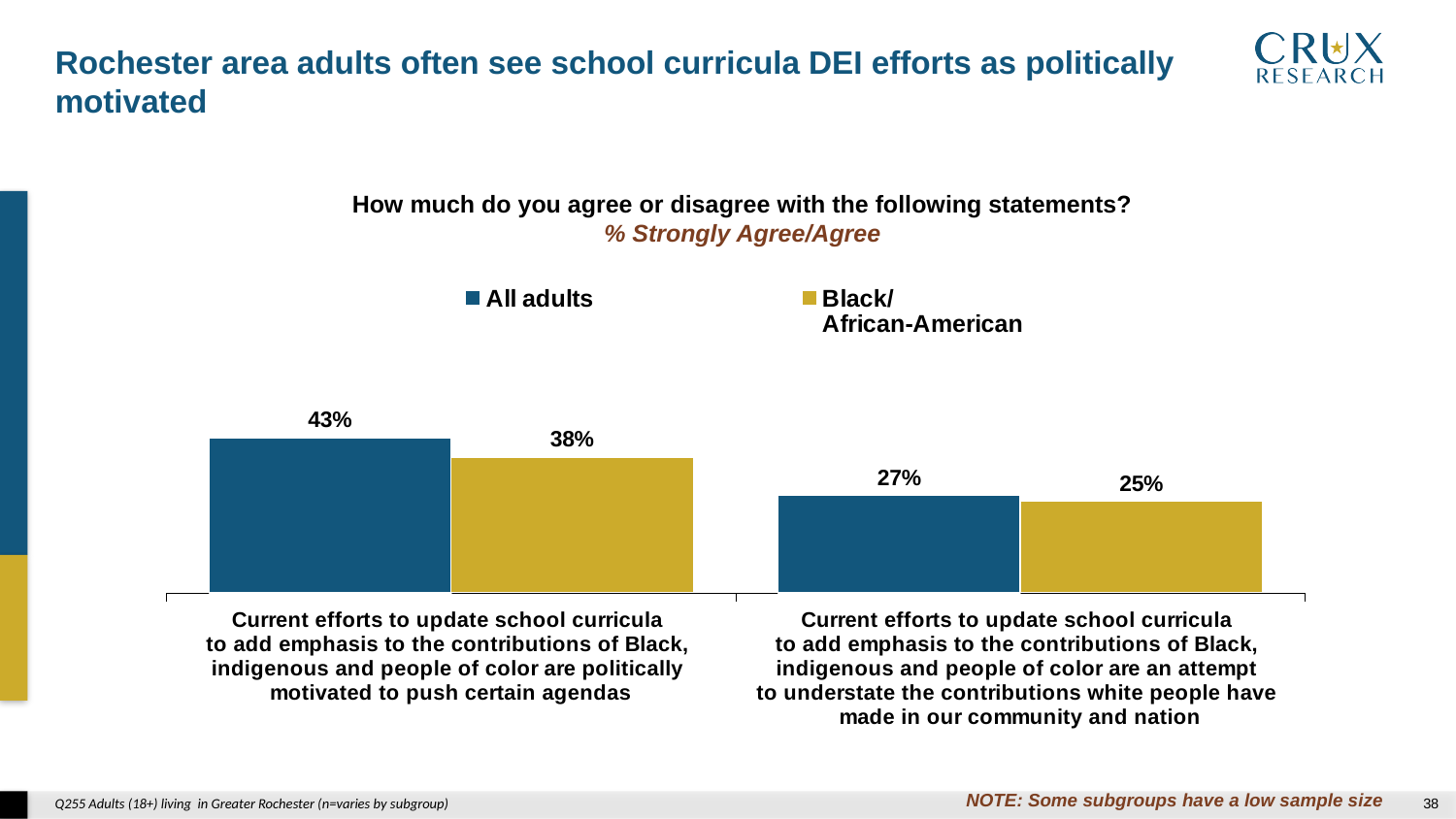
What is the difference between all adults and Black/African-American respondents for the statement that curricula efforts are politically motivated? 5 percentage points What is the difference between all adults and Black/African-American respondents for the statement that curricula efforts are an attempt to understate white people's contributions? 2 percentage points How many series does the legend list? 2 For the statement about efforts being politically motivated, which group has the larger value: all adults or Black/African-American? All adults What percentage of all adults strongly agree/agree that current efforts to update school curricula are an attempt to understate the contributions white people have made? 27% What type of chart is shown on the slide? Bar chart How many statements (categories) are shown on the chart? 2 What percentage of Black/African-American respondents strongly agree/agree that current efforts to update school curricula are an attempt to understate the contributions white people have made? 25% Which bar shows the highest value on the chart? All adults, politically motivated to push certain agendas (43%) What percentage of all adults strongly agree/agree that current efforts to update school curricula are politically motivated to push certain agendas? 43% Which bar shows the lowest value on the chart? Black/African-American, attempt to understate the contributions white people have made (25%) What percentage of Black/African-American respondents strongly agree/agree that current efforts to update school curricula are politically motivated to push certain agendas? 38%